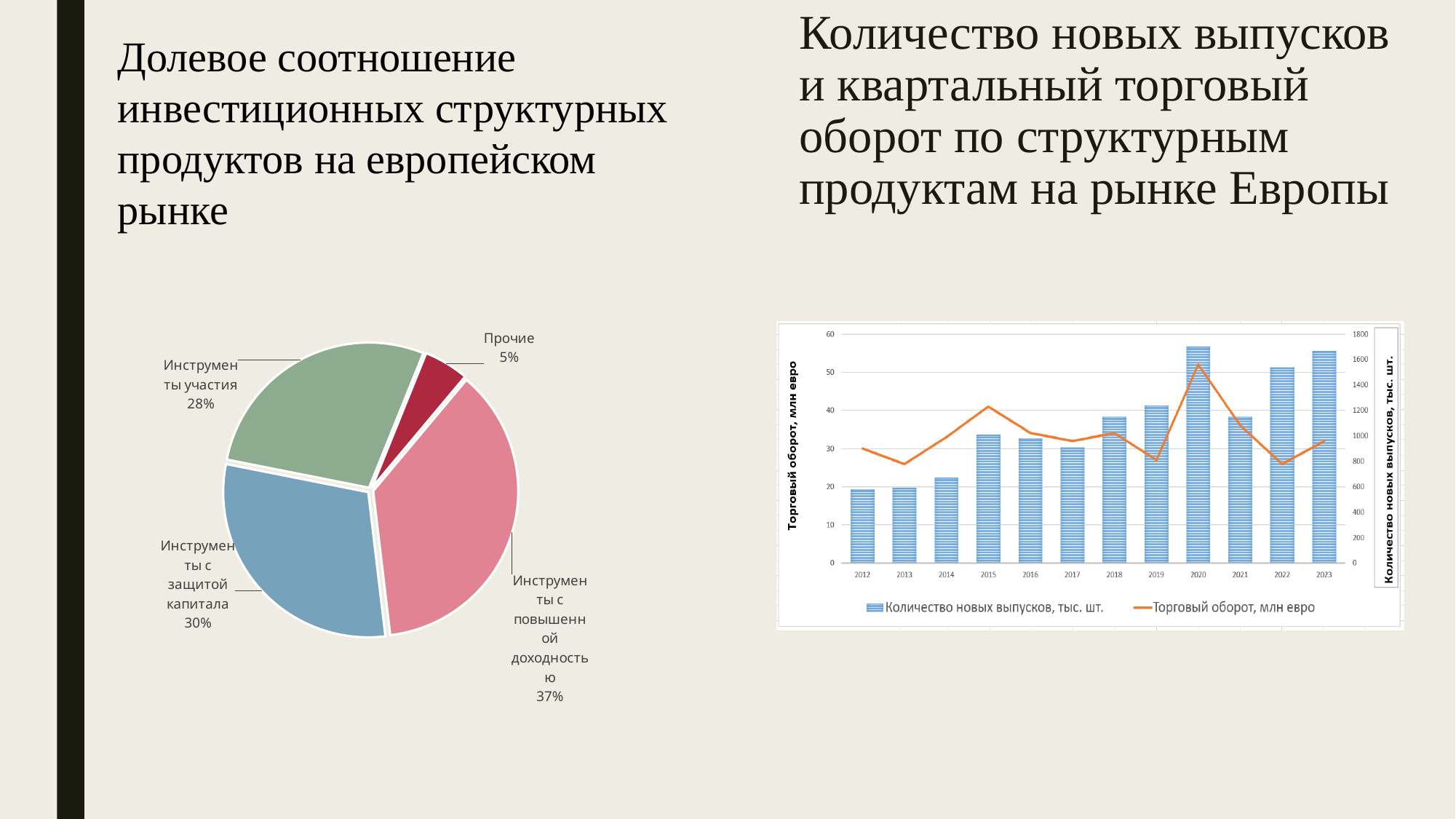
What type of chart is shown on the left of the slide? Pie chart In the pie chart on the left, which category has the smallest slice? Прочие In the pie chart on the left, what share is shown for "Инструменты с повышенной доходностью"? 37% In the chart on the right, which year has the tallest bar for "Количество новых выпусков, тыс. шт."? 2020 In the pie chart on the left, what is the difference in percentage points between "Инструменты с защитой капитала" and "Инструменты участия"? 2 How many slices does the pie chart on the left have? 4 In the chart on the right, is the bar for 2012 greater or less than 800 on the right axis? less In the pie chart on the left, what share is shown for "Прочие"? 5% In the chart on the right, how many years are shown on the x axis? 12 In the chart on the right, is the bar for 2020 greater or less than 1600 on the right axis? greater In the pie chart on the left, which category has the largest slice? Инструменты с повышенной доходностью In the chart on the right, how many series does the legend list? 2